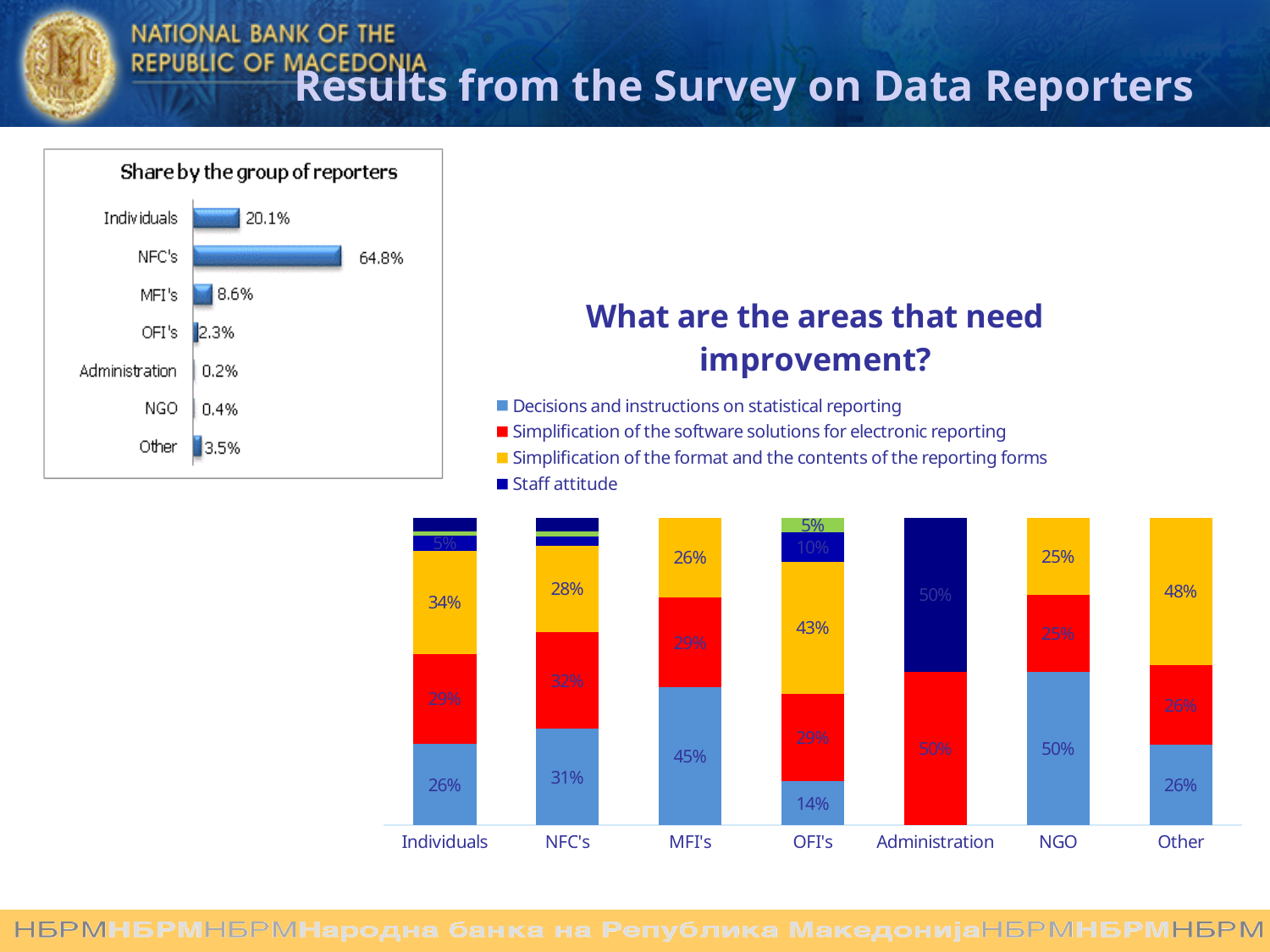
In the 'Share by the group of reporters' chart, which group has the highest share? NFC's In the 'Share by the group of reporters' chart, what is the difference between the shares of Individuals and MFI's? 11.5% In the 'What are the areas that need improvement?' chart, what is the value for 'Simplification of the format and the contents of the reporting forms' for Other? 48% What type of chart is the 'Share by the group of reporters' chart? Bar chart In the 'Share by the group of reporters' chart, what is the value for NFC's? 64.8% In the 'What are the areas that need improvement?' chart, which is larger for OFI's: 'Simplification of the format and the contents of the reporting forms' or 'Simplification of the software solutions for electronic reporting'? Simplification of the format and the contents of the reporting forms In the 'What are the areas that need improvement?' chart, how many series does the legend list? 4 In the 'What are the areas that need improvement?' chart, what is the value for 'Decisions and instructions on statistical reporting' for MFI's? 45% In the 'Share by the group of reporters' chart, how many groups of reporters are shown? 7 In the 'What are the areas that need improvement?' chart, which colour represents 'Staff attitude' in the legend? Dark blue In the 'Share by the group of reporters' chart, which group has the lowest share? Administration